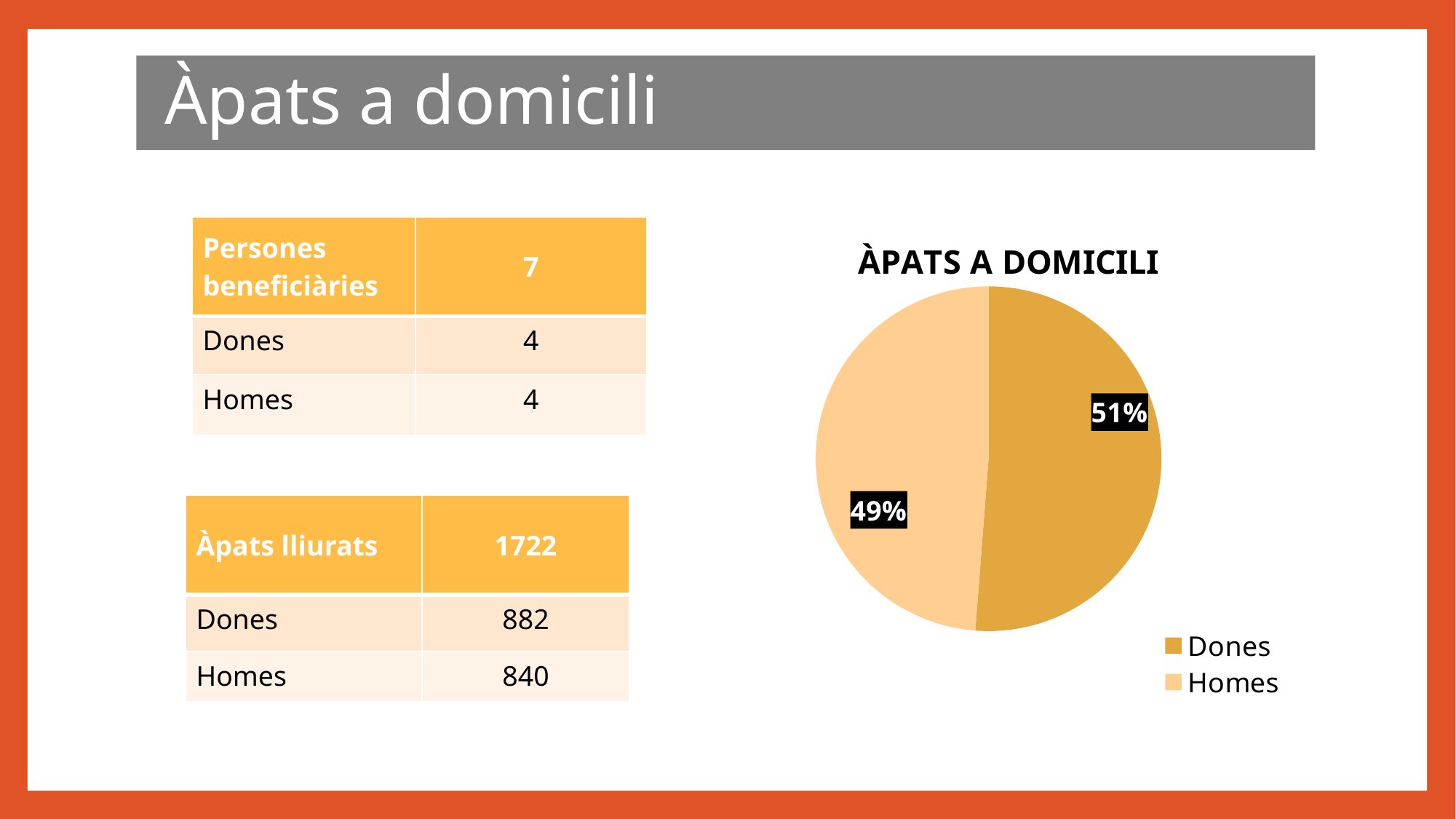
How many entries does the pie chart legend list? 2 How many slices does the pie chart have? 2 What percentage of the pie chart does Dones represent? 51% What is the title of the pie chart? ÀPATS A DOMICILI Which slice of the pie chart is the smallest? Homes What is the difference in percentage points between the Dones and Homes slices of the pie chart? 2 percentage points What percentage of the pie chart does Homes represent? 49% Which slice of the pie chart is the largest? Dones What kind of chart is shown on the slide? pie chart In the pie chart, which is larger, Dones or Homes? Dones Is the Dones slice of the pie chart greater or less than 50%? greater Which legend entry of the pie chart is shown in the lighter shade? Homes